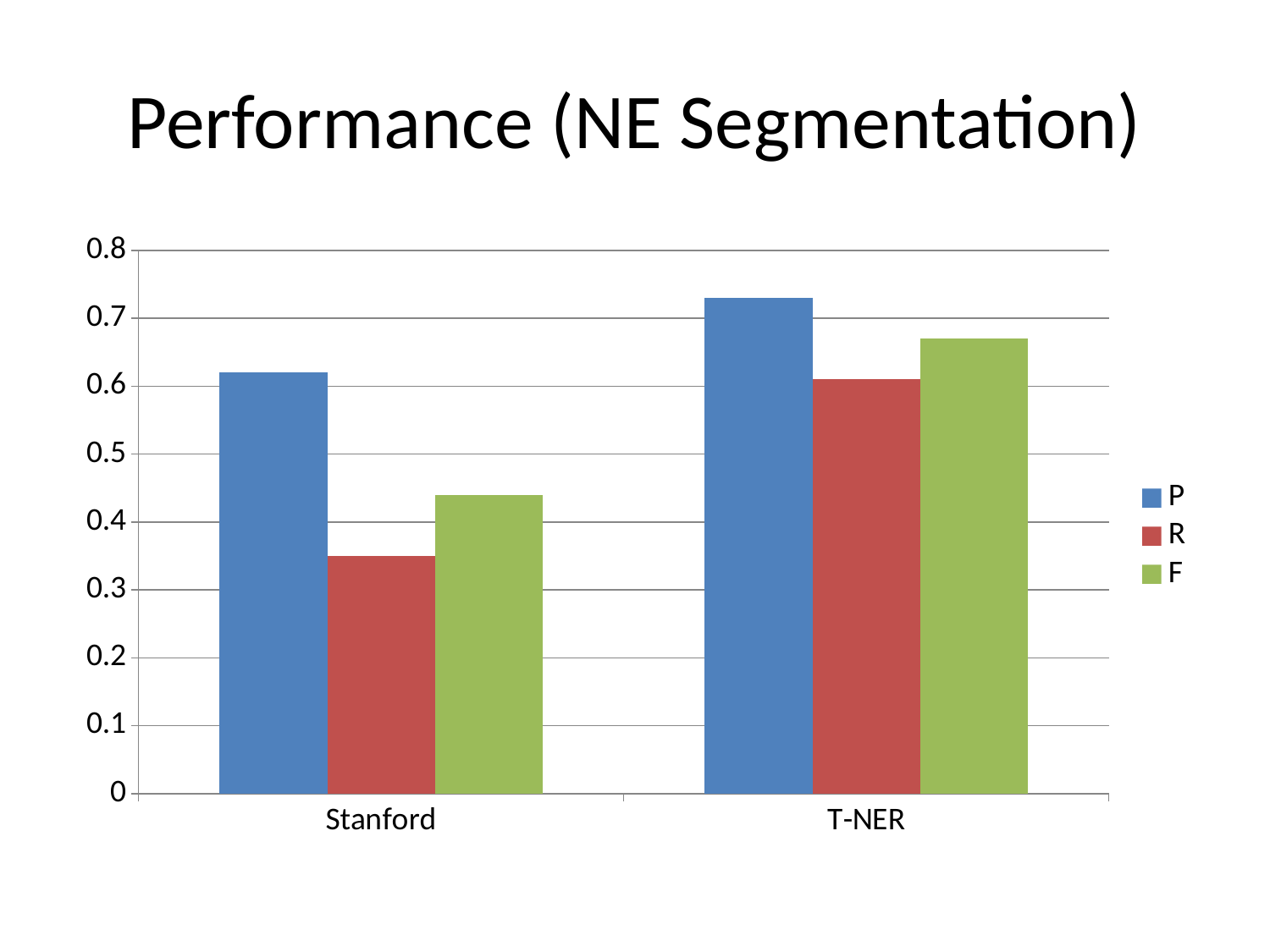
For Stanford, which is larger, the R value or the F value? F What kind of chart is shown on the slide? bar chart Which series has the lowest bar for Stanford? R Which has the larger P value, Stanford or T-NER? T-NER What is the title of the slide? Performance (NE Segmentation) Is the F value for Stanford greater or less than 0.5? less Which series has the highest bar for T-NER? P Is the R value for Stanford greater or less than 0.4? less How many series does the legend list? 3 How many categories are shown on the x axis? 2 Is the F value for T-NER greater or less than 0.6? greater